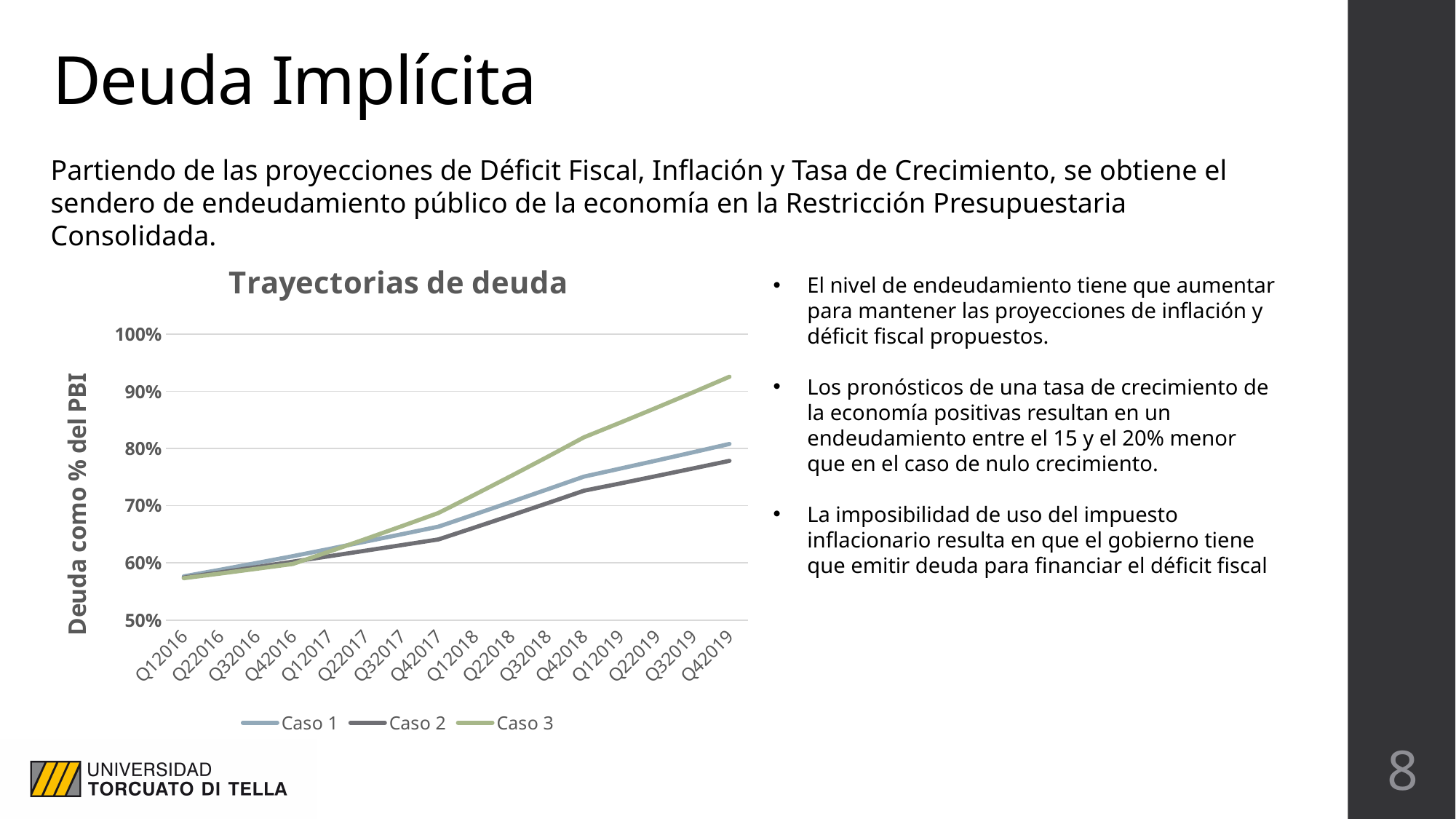
What kind of chart is shown on the slide? line chart What is the label of the vertical axis of the chart? Deuda como % del PBI Is the value for Caso 2 at Q42019 greater or less than 80%? less Is the value for Caso 3 at Q42019 greater or less than 90%? greater How many quarters are plotted along the x axis of the chart? 16 Which series has the highest value at Q42019? Caso 3 Which series has the lowest value at Q42019? Caso 2 How many series does the legend of the chart list? 3 Do the debt trajectories rise or fall from Q12016 to Q42019? rise What is the title of the chart? Trayectorias de deuda Is the value for Caso 1 at Q12016 greater or less than 60%? less